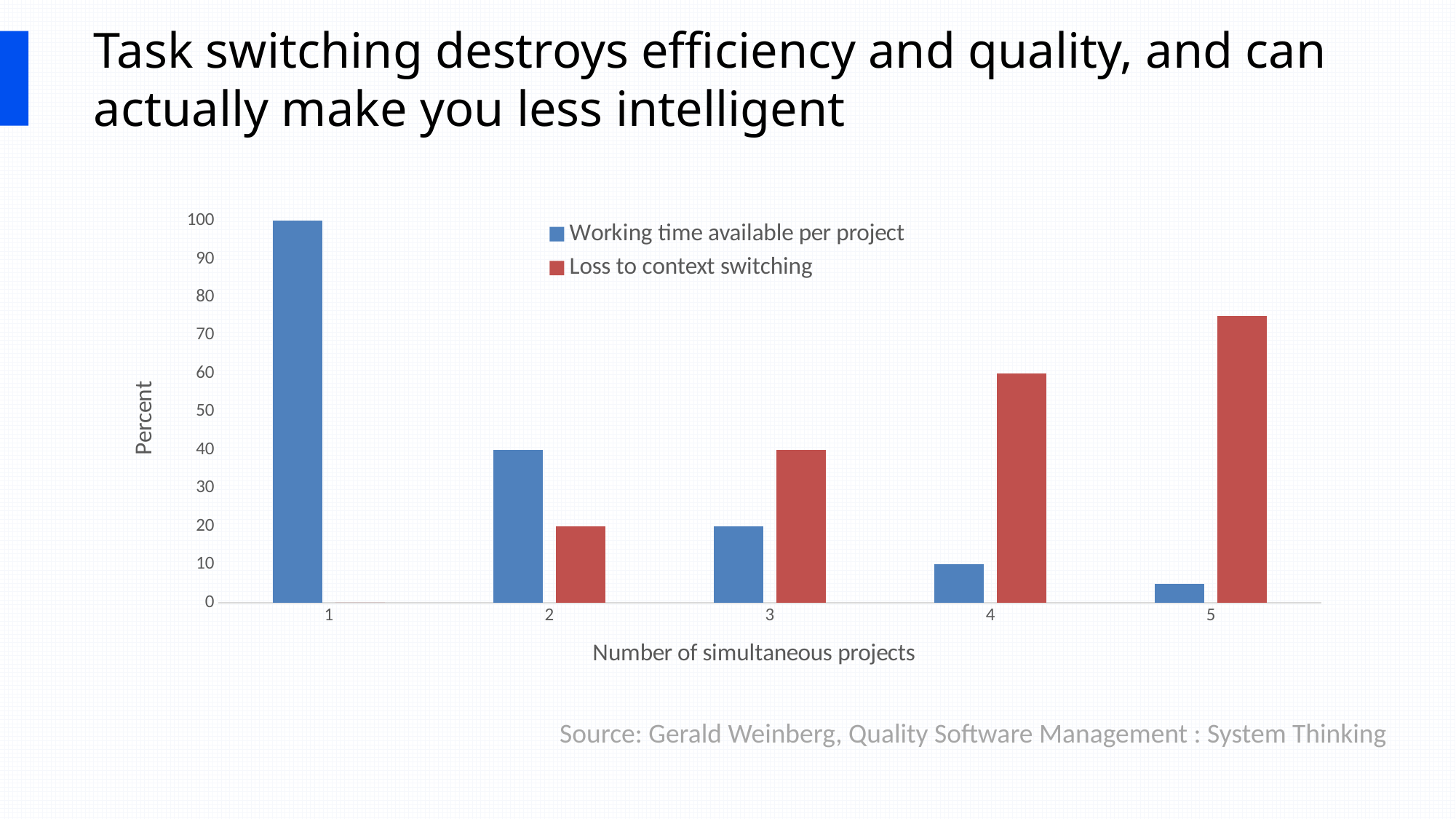
What is the value of Loss to context switching for 4 simultaneous projects? 60 What is the difference between Loss to context switching and Working time available per project for 3 simultaneous projects? 20 Is the value of Loss to context switching for 5 simultaneous projects greater or less than 70? greater What is the value of Working time available per project for 1 simultaneous project? 100 How many categories are shown on the x axis? 5 For which number of simultaneous projects is Working time available per project highest? 1 What kind of chart is shown on the slide? bar chart Is the value of Working time available per project for 5 simultaneous projects greater or less than 10? less What is the value of Working time available per project for 2 simultaneous projects? 40 How many series does the legend list? 2 For which number of simultaneous projects is Loss to context switching highest? 5 Does Working time available per project rise or fall as the number of simultaneous projects increases? fall